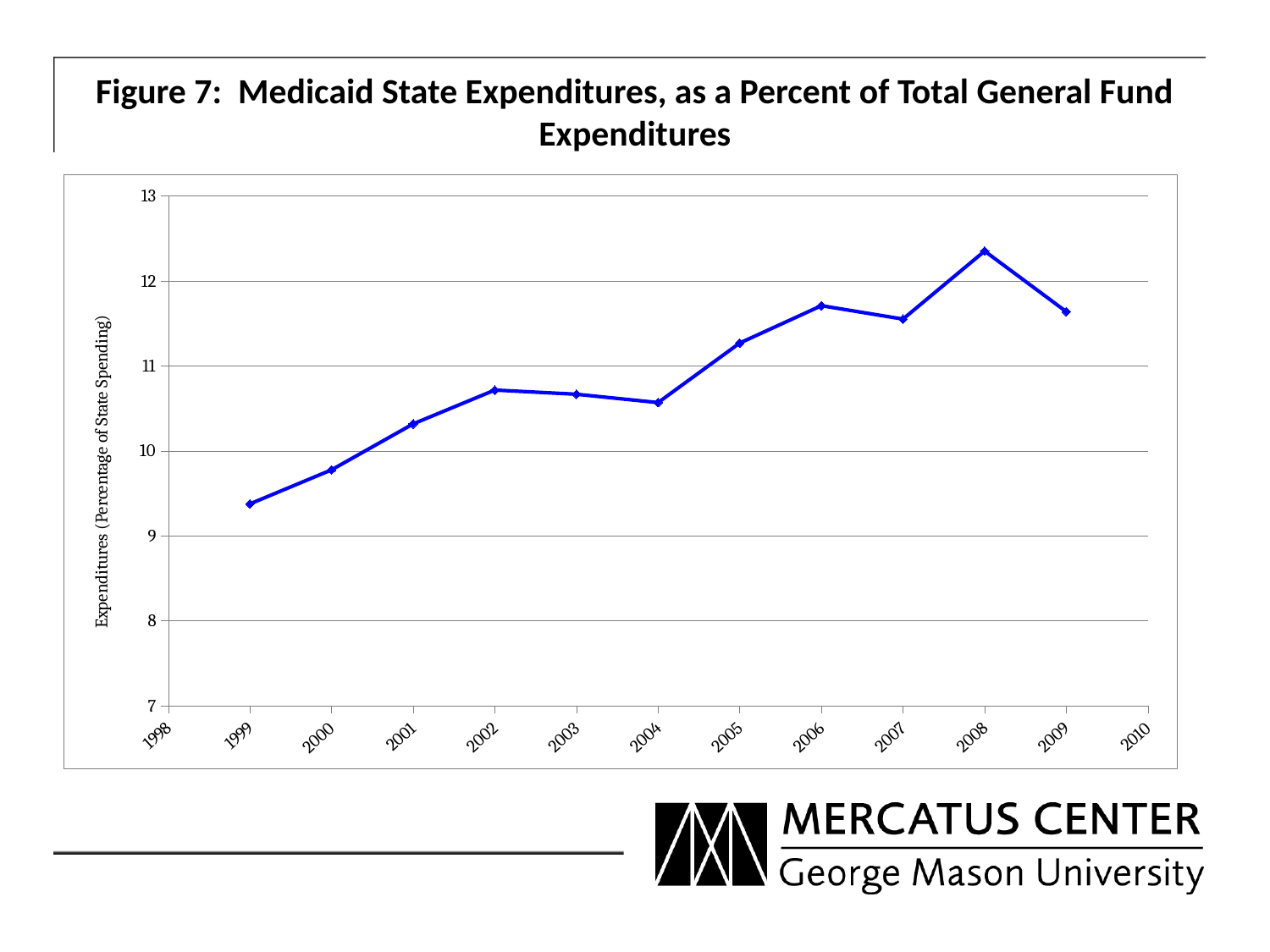
Is the value for 2008 greater or less than 12? greater In which year is Medicaid state expenditure as a percent of general fund expenditures highest? 2008 In which year is Medicaid state expenditure as a percent of general fund expenditures lowest? 1999 Is the value for 1999 greater or less than 10? less What is the label on the vertical axis? Expenditures (Percentage of State Spending) What kind of chart is shown on the slide? line chart How many data points are plotted on the line? 11 Which year has the larger value, 2004 or 2006? 2006 Do the values rise or fall from 1999 to 2002? rise Is the value for 2005 greater or less than 11? greater Which year has the larger value, 2008 or 2009? 2008